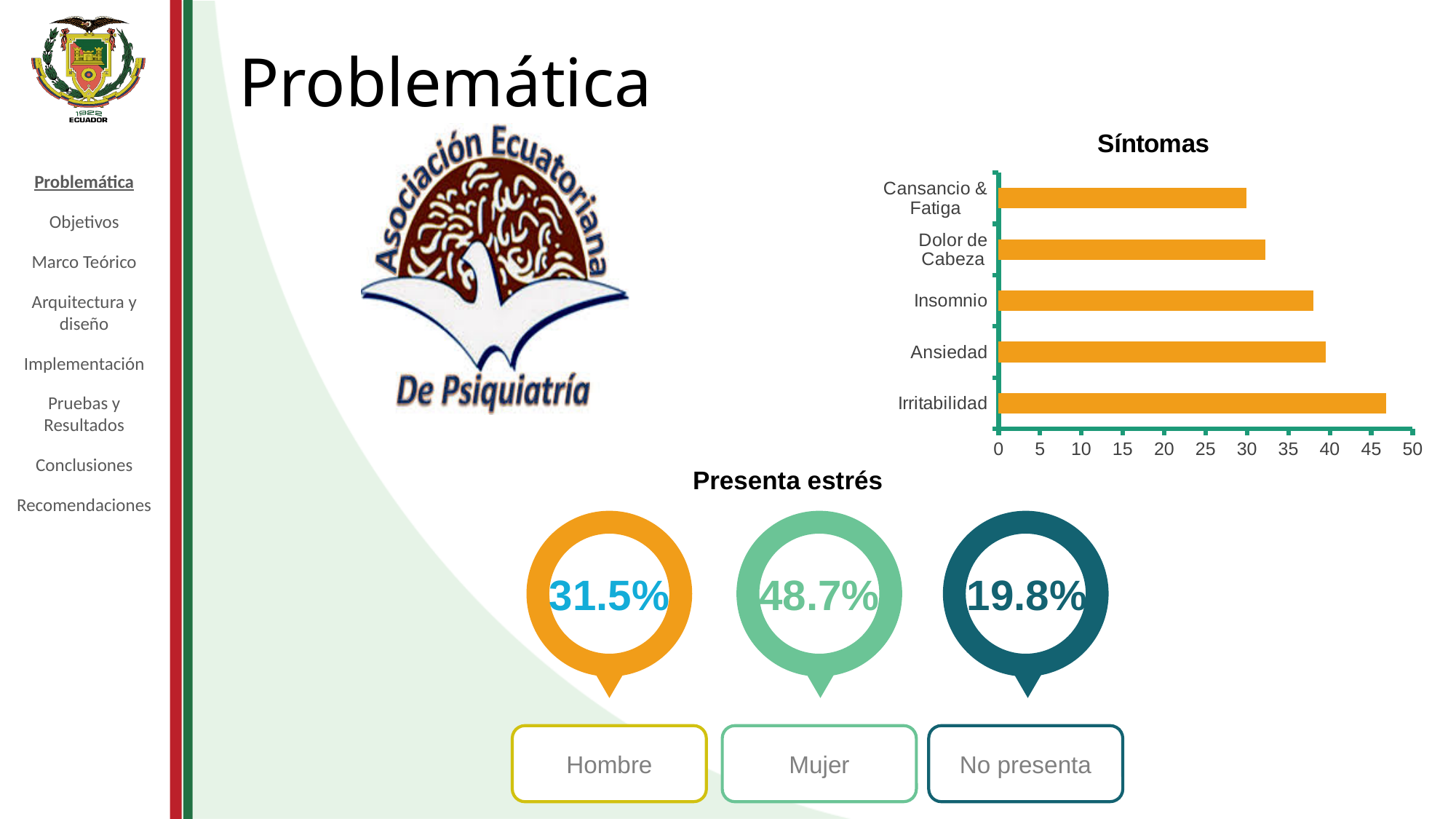
How many categories are shown in the "Síntomas" chart? 5 In the "Síntomas" chart, which is larger: Insomnio or Dolor de Cabeza? Insomnio In the "Síntomas" chart, is the value for Ansiedad greater or less than 35? greater What is the title of the bar chart on the slide? Síntomas In the "Síntomas" chart, is the value for Irritabilidad greater or less than 40? greater In the "Síntomas" chart, is the value for Dolor de Cabeza greater or less than 35? less Which category has the highest value in the "Síntomas" chart? Irritabilidad In the "Síntomas" chart, which is larger: Irritabilidad or Ansiedad? Irritabilidad Which category has the lowest value in the "Síntomas" chart? Cansancio & Fatiga What kind of chart is the "Síntomas" chart? bar chart